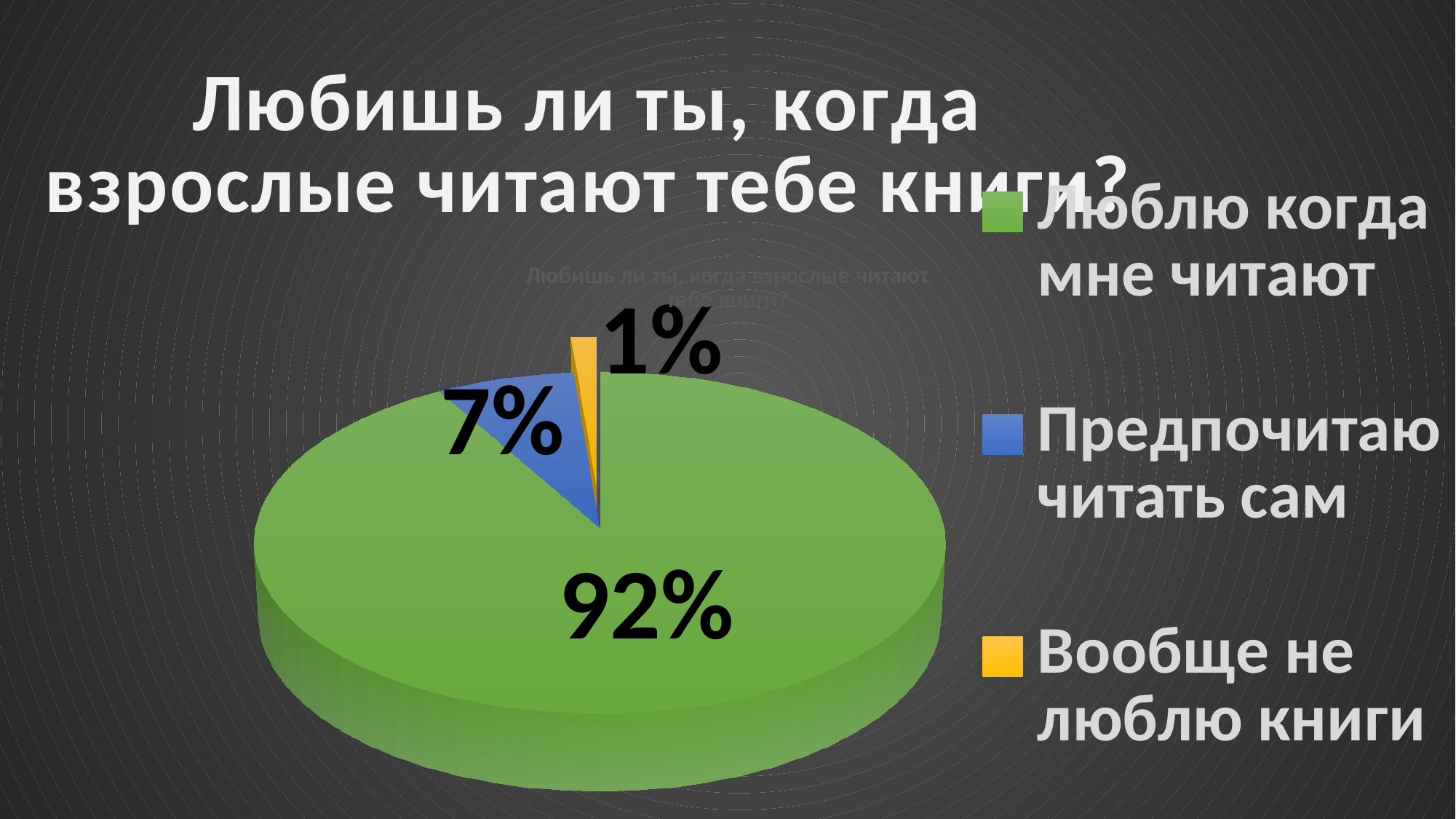
Which category has the smallest slice of the pie? Вообще не люблю книги Which category has the largest slice of the pie? Люблю когда мне читают What share of the pie is labelled "Предпочитаю читать сам"? 7% What colour is the slice for "Вообще не люблю книги"? yellow What share of the pie is labelled "Люблю когда мне читают"? 92% What is the difference in percentage points between "Предпочитаю читать сам" and "Вообще не люблю книги"? 6 Which is larger: the slice for "Предпочитаю читать сам" or the slice for "Вообще не люблю книги"? Предпочитаю читать сам What kind of chart is shown on the slide? pie chart What colour is the slice for "Предпочитаю читать сам"? blue What share of the pie is labelled "Вообще не люблю книги"? 1% How many slices does the pie chart have? 3 What is the difference in percentage points between "Люблю когда мне читают" and "Предпочитаю читать сам"? 85